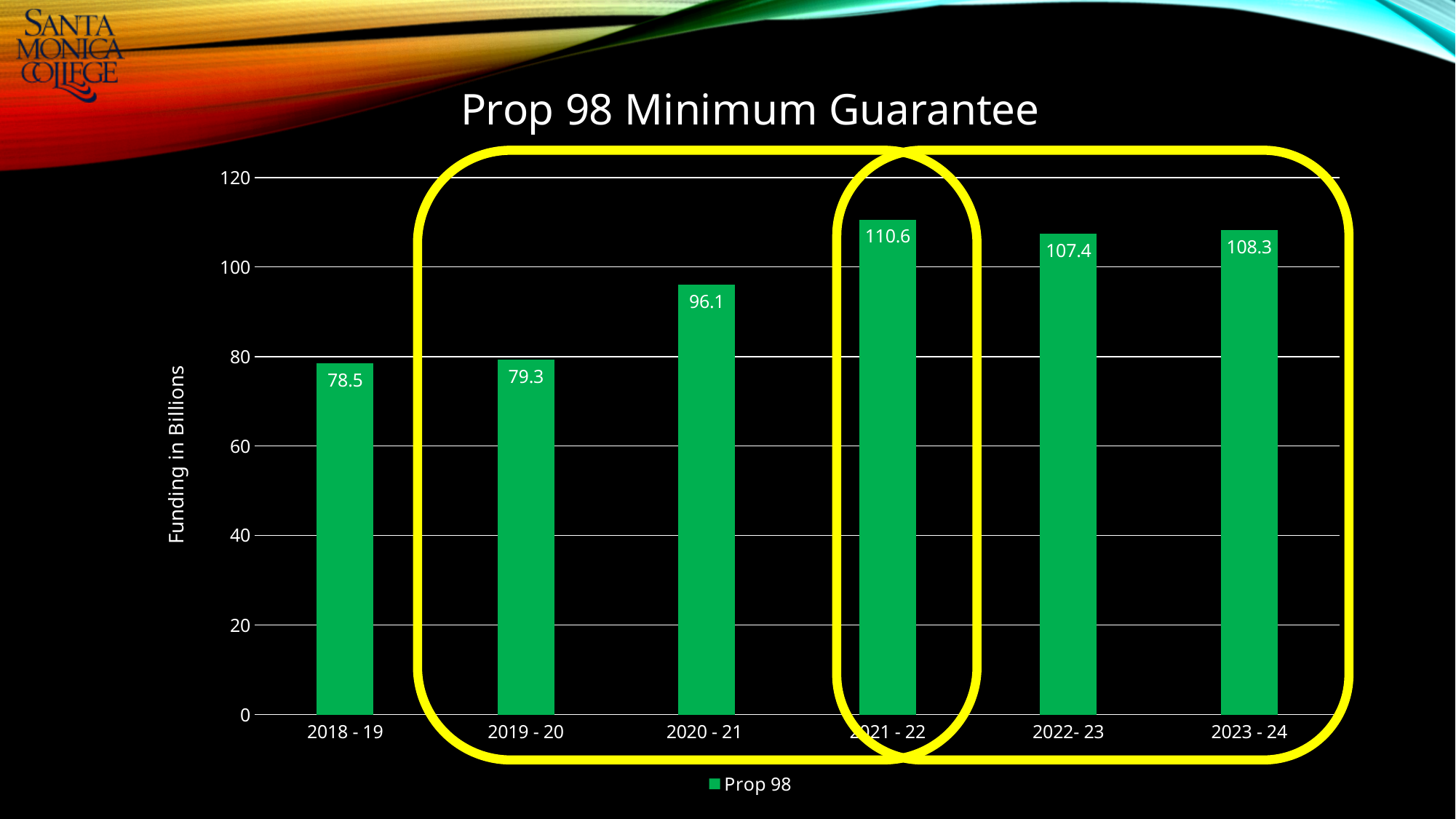
Which is larger, the Prop 98 value for 2022- 23 or for 2023 - 24? 2023 - 24 What kind of chart is shown on the slide? bar chart What is the Prop 98 minimum guarantee value for 2018 - 19? 78.5 Which year has the highest Prop 98 minimum guarantee? 2021 - 22 What is the label of the y axis of the chart? Funding in Billions What is the Prop 98 minimum guarantee value for 2023 - 24? 108.3 Is the Prop 98 value for 2020 - 21 greater or less than 100? less How many years are shown on the x axis of the chart? 6 What is the Prop 98 minimum guarantee value for 2021 - 22? 110.6 What is the difference between the Prop 98 values for 2021 - 22 and 2022- 23? 3.2 What is the difference between the Prop 98 values for 2020 - 21 and 2019 - 20? 16.8 Which year has the lowest Prop 98 minimum guarantee? 2018 - 19